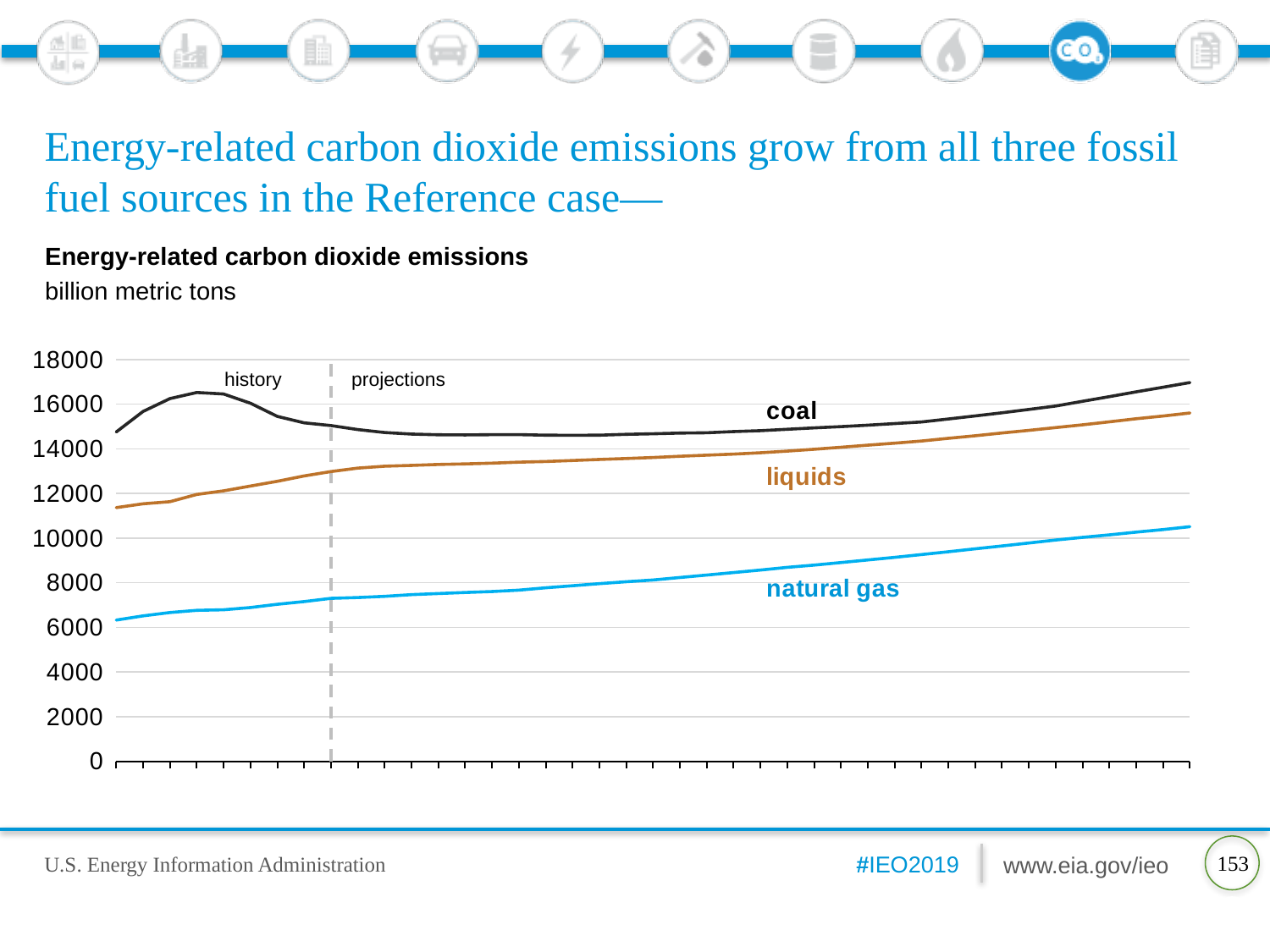
Is the value for natural gas at the left end of the chart greater or less than 8000? less Does the natural gas line rise or fall across the projection period? rise Is the value for liquids at the left end of the chart greater or less than 12000? less How many series are plotted on the chart? 3 What unit is used for the y axis of the chart? billion metric tons What is the title of the chart? Energy-related carbon dioxide emissions Which series is larger at the right end of the chart, liquids or natural gas? liquids Which series has the lowest emissions throughout the chart? natural gas Which series has the highest emissions throughout the chart? coal What kind of chart is shown on the slide? line chart Is the value for natural gas at the right end of the chart greater or less than 8000? greater